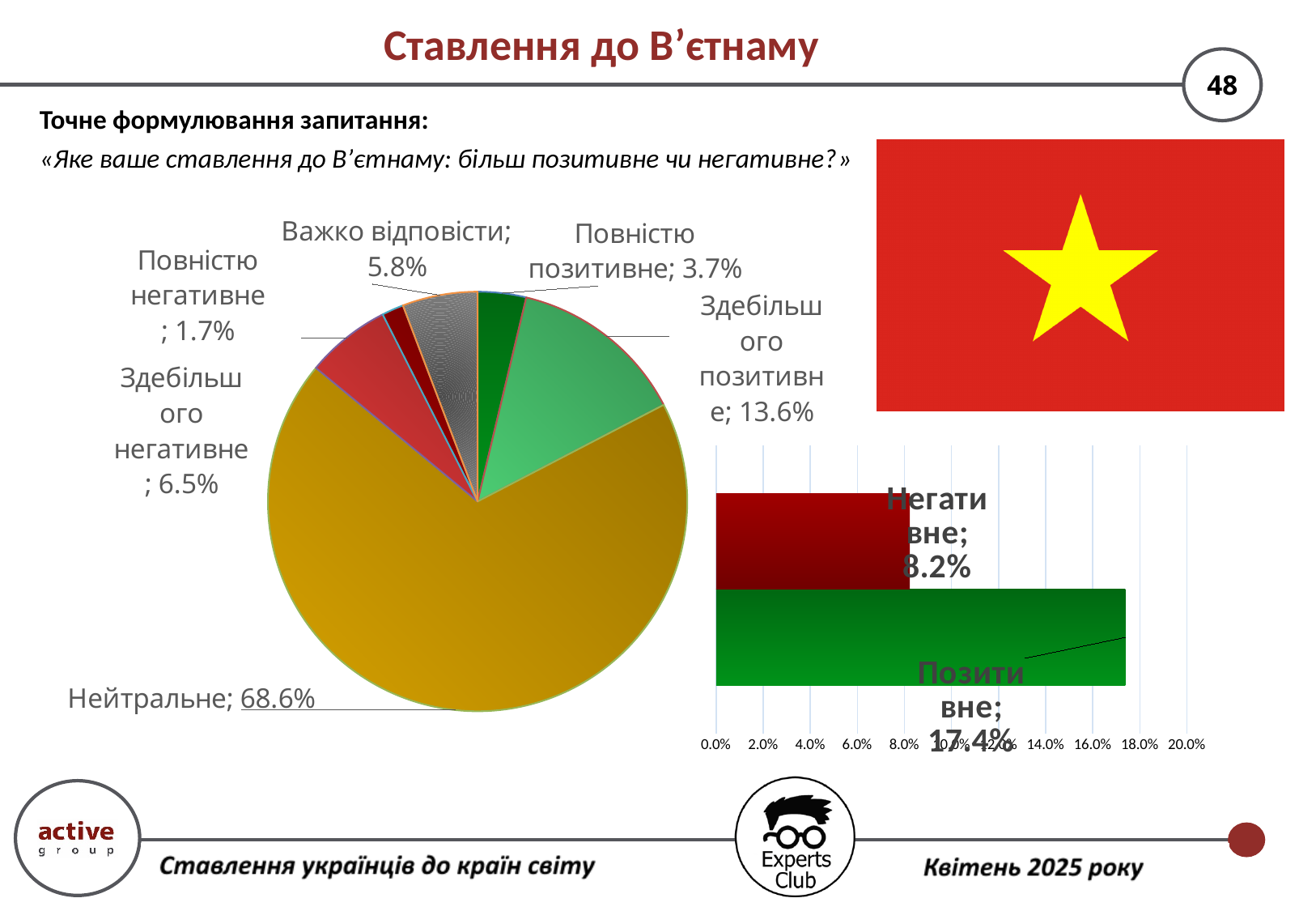
In the pie chart on the left, which is larger: "Важко відповісти" or "Повністю позитивне"? Важко відповісти In the bar chart on the right, what is the value for "Позитивне"? 17.4% In the pie chart on the left, what is the value for "Повністю негативне"? 1.7% In the pie chart on the left, which category has the smallest share? Повністю негативне In the bar chart on the right, what is the value for "Негативне"? 8.2% In the pie chart on the left, what is the value for "Здебільшого позитивне"? 13.6% In the pie chart on the left, what is the difference between "Здебільшого позитивне" and "Здебільшого негативне"? 7.1% What type of chart is shown on the right side of the slide? Bar chart In the pie chart on the left, how many categories are shown? 6 In the bar chart on the right, what is the difference between "Позитивне" and "Негативне"? 9.2% In the pie chart on the left, which category has the largest share? Нейтральне In the pie chart on the left, what is the value for "Нейтральне"? 68.6%